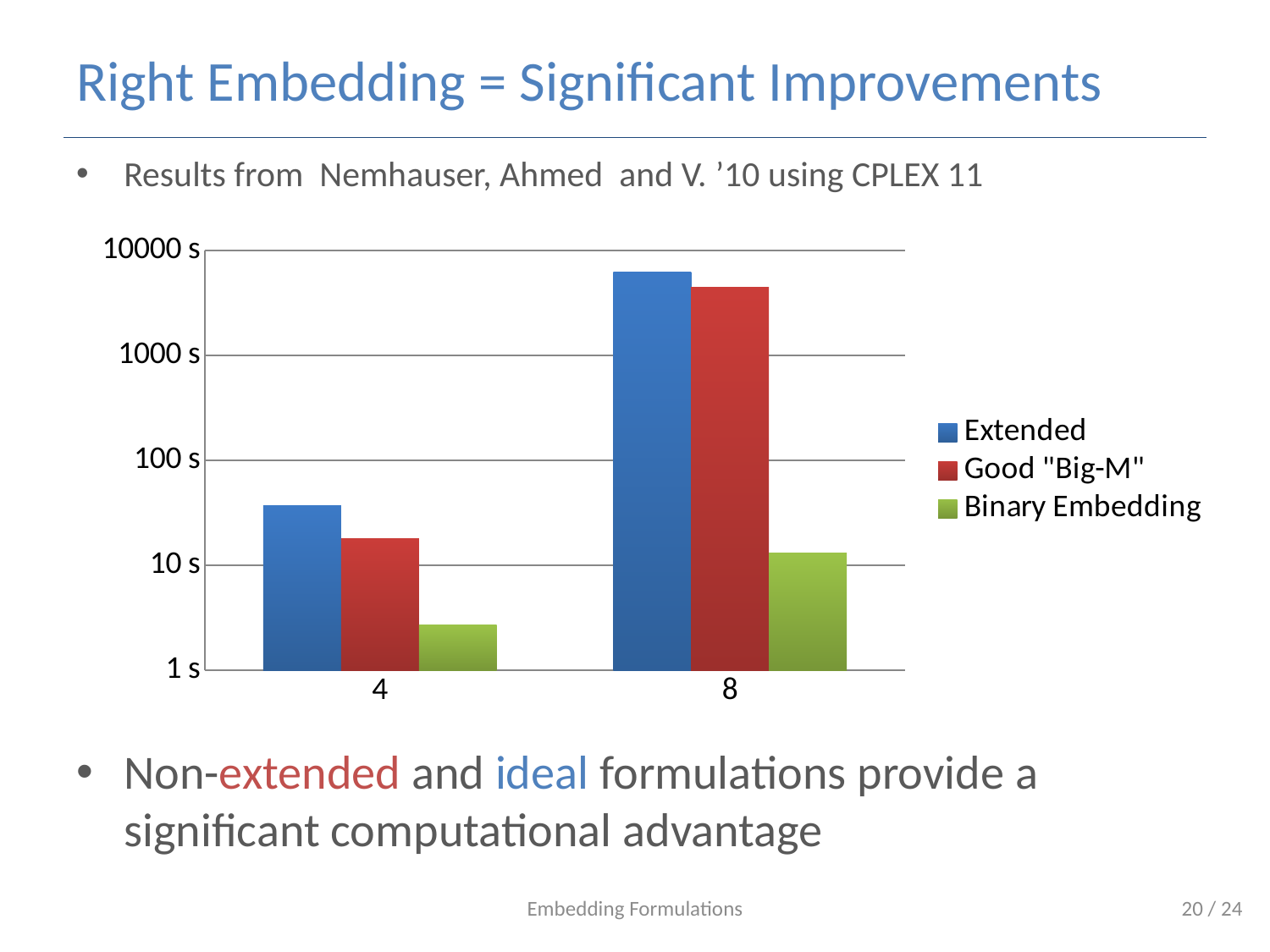
Is the value for Good "Big-M" at category 4 greater or less than 100 s? less Which series has the lowest value for category 4? Binary Embedding How many categories are shown on the x axis? 2 What is the highest tick label shown on the y axis? 10000 s Is the value for Extended at category 8 greater or less than 1000 s? greater Is the value for Binary Embedding at category 4 greater or less than 10 s? less Which is larger for category 8: Extended or Binary Embedding? Extended Does the value for Extended rise or fall from category 4 to category 8? rise Which series has the highest value for category 4? Extended Which series has the lowest value for category 8? Binary Embedding What kind of chart is shown on the slide? bar chart How many series does the legend list? 3